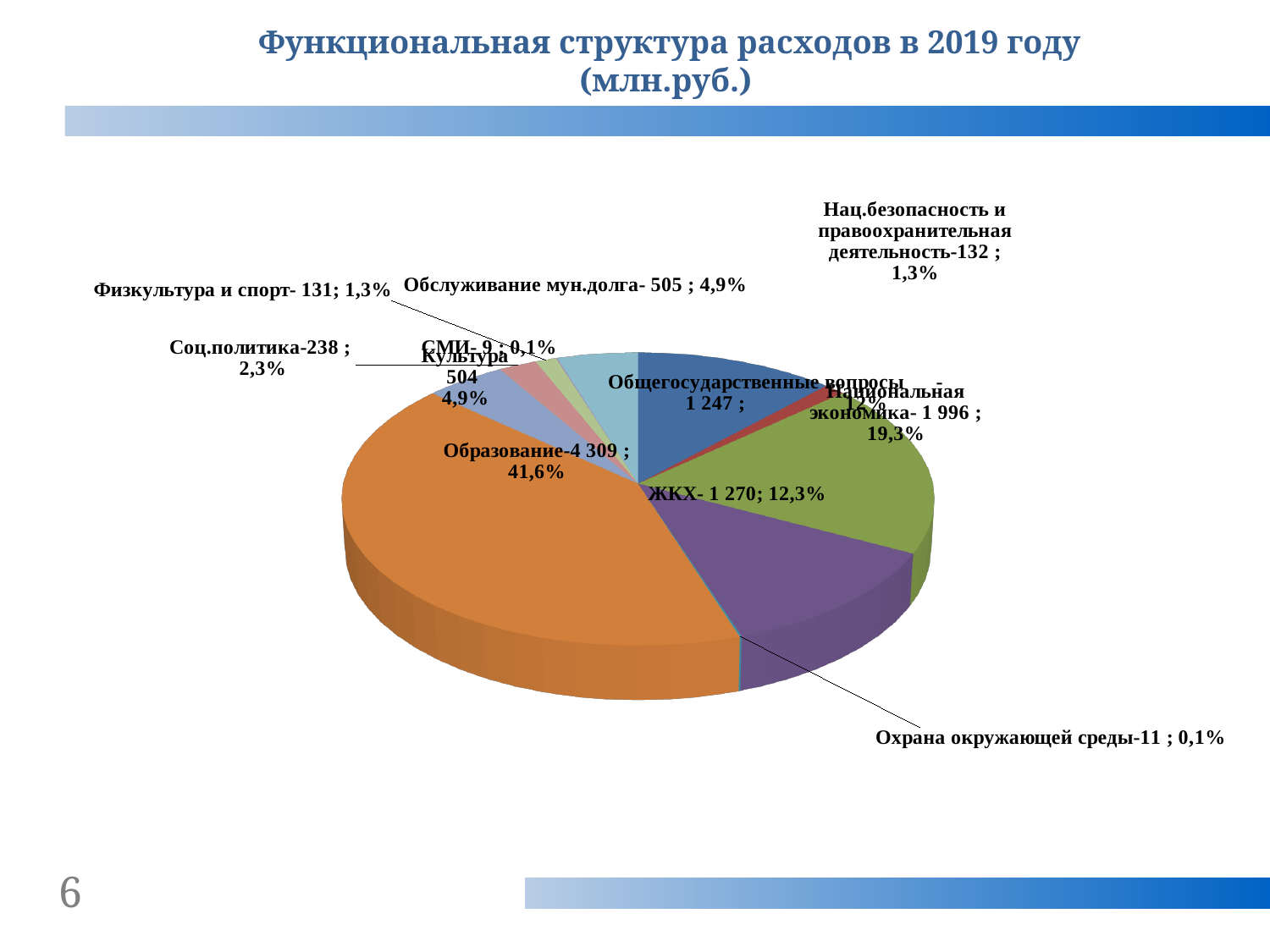
Which category has the smallest value (млн.руб.)? СМИ What is the value for Образование (млн.руб.)? 4 309 What is the value for Национальная экономика (млн.руб.)? 1 996 Which category has the largest share of expenditures? Образование What percentage share is shown for ЖКХ? 12,3% How many categories are shown in the pie chart? 11 What is the difference in млн.руб. between Образование and Национальная экономика? 2 313 Which is larger: ЖКХ or Национальная экономика? Национальная экономика What share of expenditures does Образование account for? 41,6% What kind of chart is shown on the slide? Pie chart What is the value for Обслуживание мун.долга (млн.руб.)? 505 What is the title of the chart? Функциональная структура расходов в 2019 году (млн.руб.)